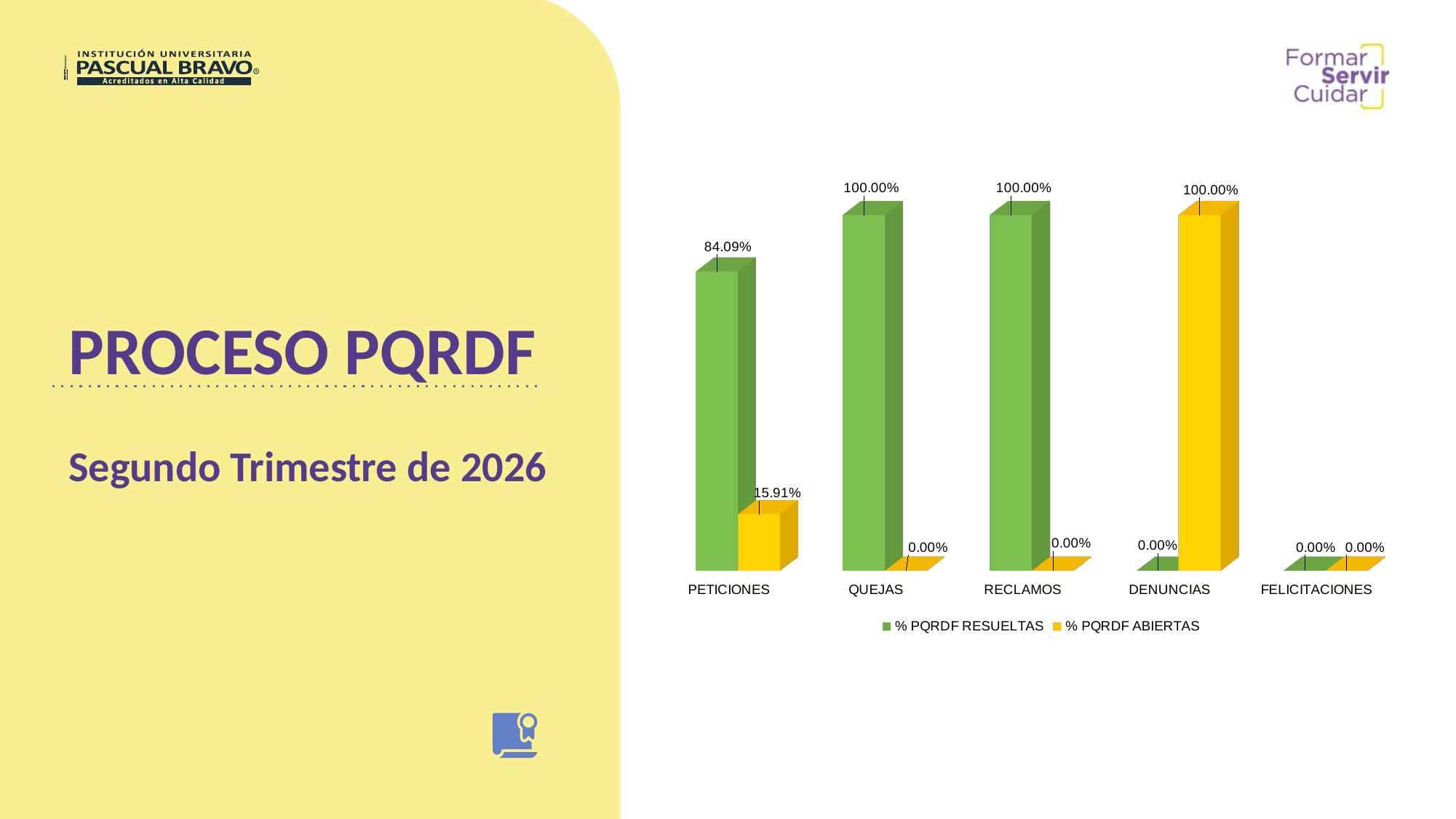
What kind of chart is shown on the slide? Bar chart Which is larger for PETICIONES: % PQRDF RESUELTAS or % PQRDF ABIERTAS? % PQRDF RESUELTAS Which category has the highest % PQRDF ABIERTAS value? DENUNCIAS What is the difference between the % PQRDF RESUELTAS and % PQRDF ABIERTAS values for PETICIONES? 68.18% What is the % PQRDF RESUELTAS value for FELICITACIONES? 0.00% Which category has the lowest % PQRDF RESUELTAS value? DENUNCIAS and FELICITACIONES (both 0.00%) How many series does the chart legend list? 2 What is the % PQRDF RESUELTAS value for PETICIONES? 84.09% How many categories are shown on the x axis of the chart? 5 What is the % PQRDF RESUELTAS value for QUEJAS? 100.00% What is the % PQRDF ABIERTAS value for PETICIONES? 15.91% What is the % PQRDF ABIERTAS value for DENUNCIAS? 100.00%